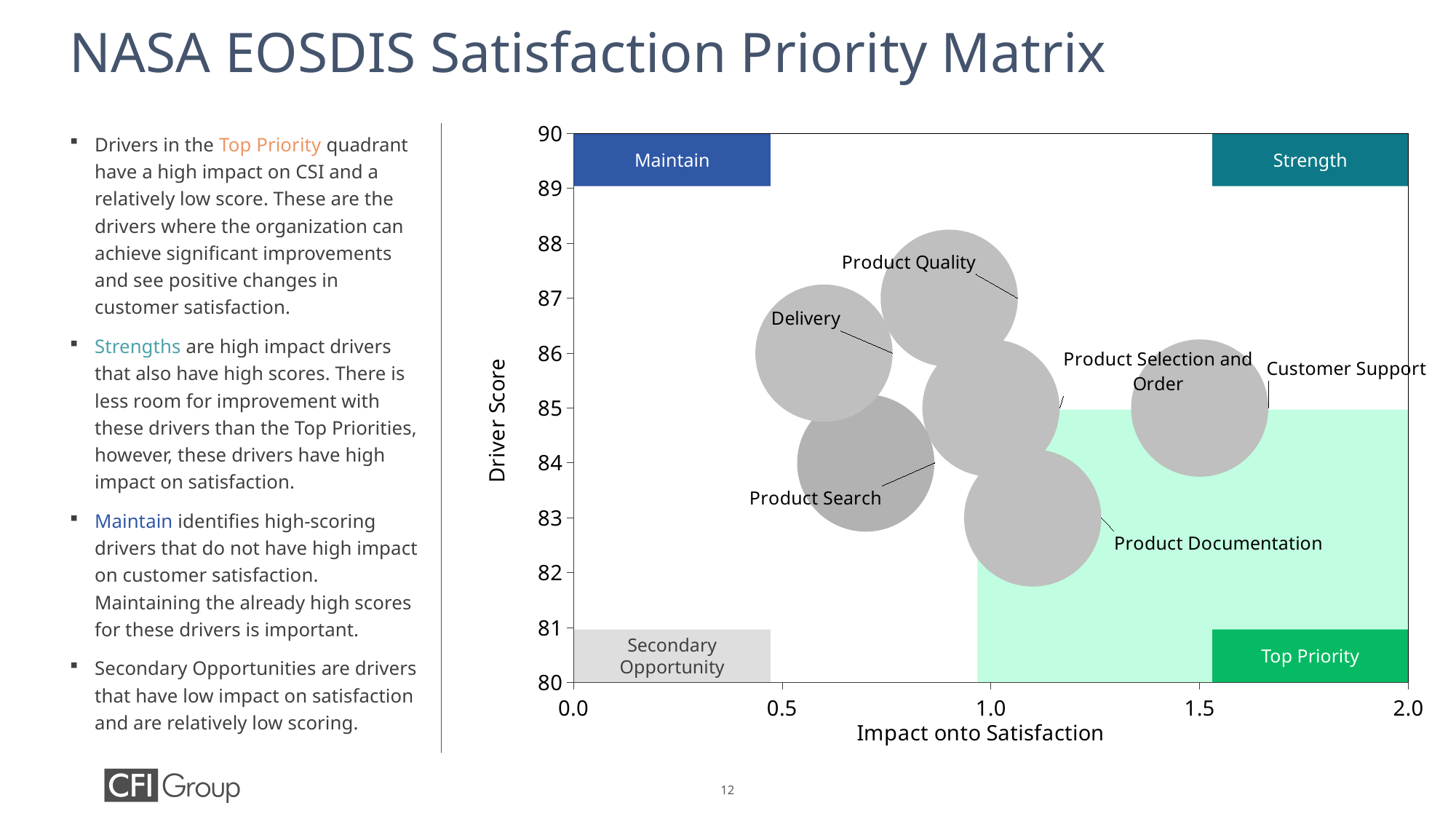
Which driver has the highest Driver Score? Product Quality Which has the higher Impact onto Satisfaction, Customer Support or Delivery? Customer Support What label is shown in the top-right quadrant of the chart? Strength How many drivers (bubbles) are plotted on the chart? 6 Which driver has the highest Impact onto Satisfaction? Customer Support Is the Impact onto Satisfaction for Customer Support greater or less than 1.0? greater Which driver has the lowest Driver Score? Product Documentation Is the Impact onto Satisfaction for Delivery greater or less than 1.0? less Is the Driver Score for Product Documentation greater or less than 85? less Which has the higher Driver Score, Product Quality or Product Documentation? Product Quality What is the title of the horizontal axis of the chart? Impact onto Satisfaction What kind of chart is shown on the slide? Bubble chart